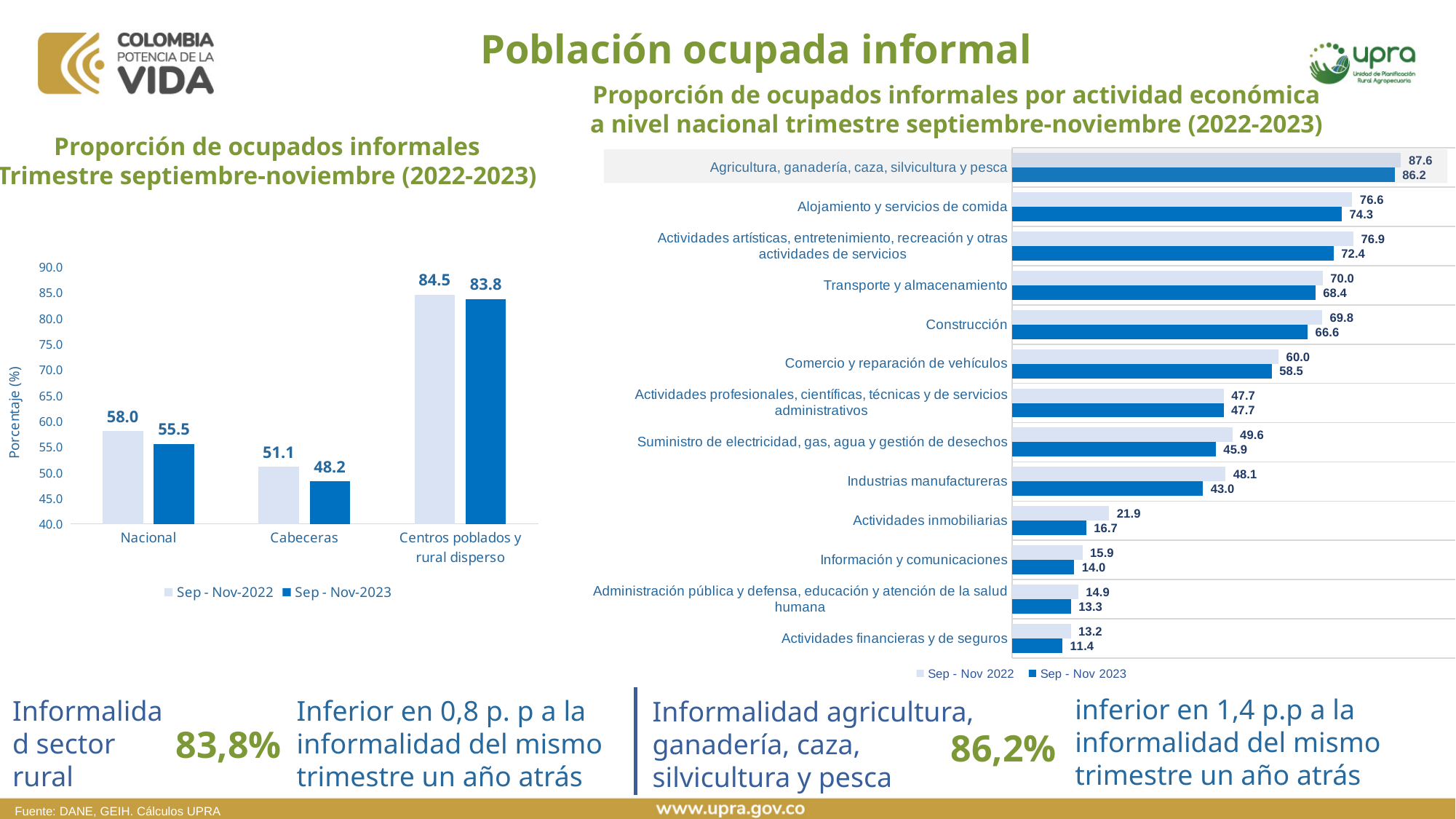
In the right chart (Proporción de ocupados informales por actividad económica), which activity has the lowest Sep - Nov 2023 value? Actividades financieras y de seguros In the left chart (Proporción de ocupados informales, Trimestre septiembre-noviembre), what is the difference between the Sep - Nov-2022 and Sep - Nov-2023 values for Nacional? 2.5 In the right chart (Proporción de ocupados informales por actividad económica), what is the Sep - Nov 2023 value for Construcción? 66.6 In the left chart (Proporción de ocupados informales, Trimestre septiembre-noviembre), which category has the highest value for Sep - Nov-2022? Centros poblados y rural disperso In the right chart (Proporción de ocupados informales por actividad económica), which is larger: the Sep - Nov 2023 value for Transporte y almacenamiento or for Comercio y reparación de vehículos? Transporte y almacenamiento In the left chart (Proporción de ocupados informales, Trimestre septiembre-noviembre), what is the value for Cabeceras in Sep - Nov-2023? 48.2 In the right chart (Proporción de ocupados informales por actividad económica), how many series does the legend list? 2 What kind of chart is the left chart (Proporción de ocupados informales, Trimestre septiembre-noviembre)? Bar chart In the right chart (Proporción de ocupados informales por actividad económica), what is the difference between the Sep - Nov 2022 and Sep - Nov 2023 values for Industrias manufactureras? 5.1 In the left chart (Proporción de ocupados informales, Trimestre septiembre-noviembre), how many categories are shown on the x axis? 3 In the right chart (Proporción de ocupados informales por actividad económica), which activity has the highest Sep - Nov 2022 value? Agricultura, ganadería, caza, silvicultura y pesca In the right chart (Proporción de ocupados informales por actividad económica), how many economic activities are listed? 13